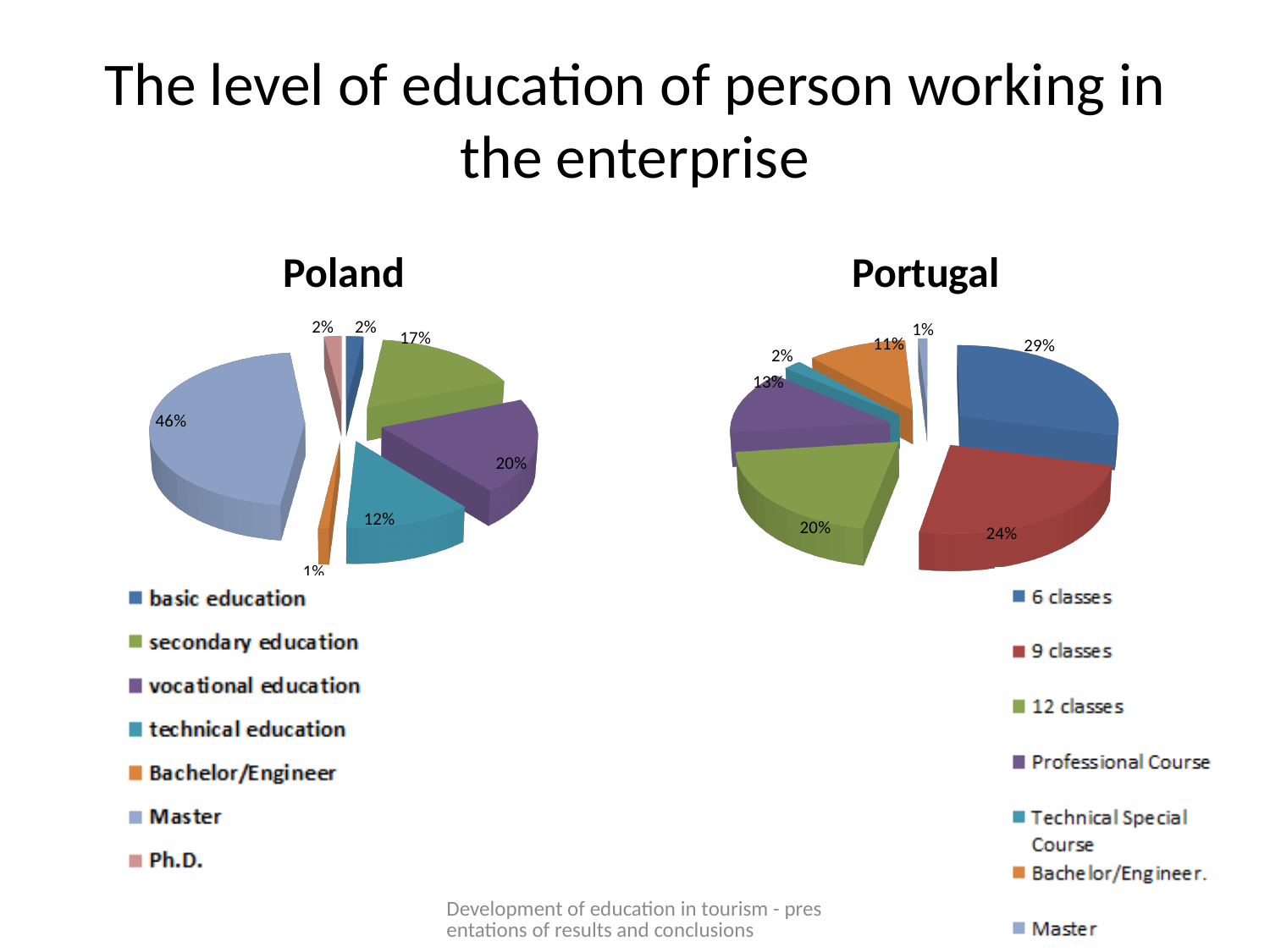
In the Portugal chart, what is the difference between the 6 classes slice and the 9 classes slice? 5% In the Poland chart, what share of the pie is Bachelor/Engineer? 1% In the Poland chart, what share of the pie is Master? 46% How many categories does the Poland chart's legend list? 7 In the Poland chart, which category has the largest slice? Master How many categories does the Portugal chart's legend list? 7 In the Portugal chart, what share of the pie is Professional Course? 13% In the Poland chart, what share of the pie is vocational education? 20% In the Portugal chart, what share of the pie is 6 classes? 29% In the Portugal chart, which category has the smallest slice? Master In the Poland chart, which is larger: secondary education or technical education? secondary education What kind of chart is the Portugal chart? pie chart